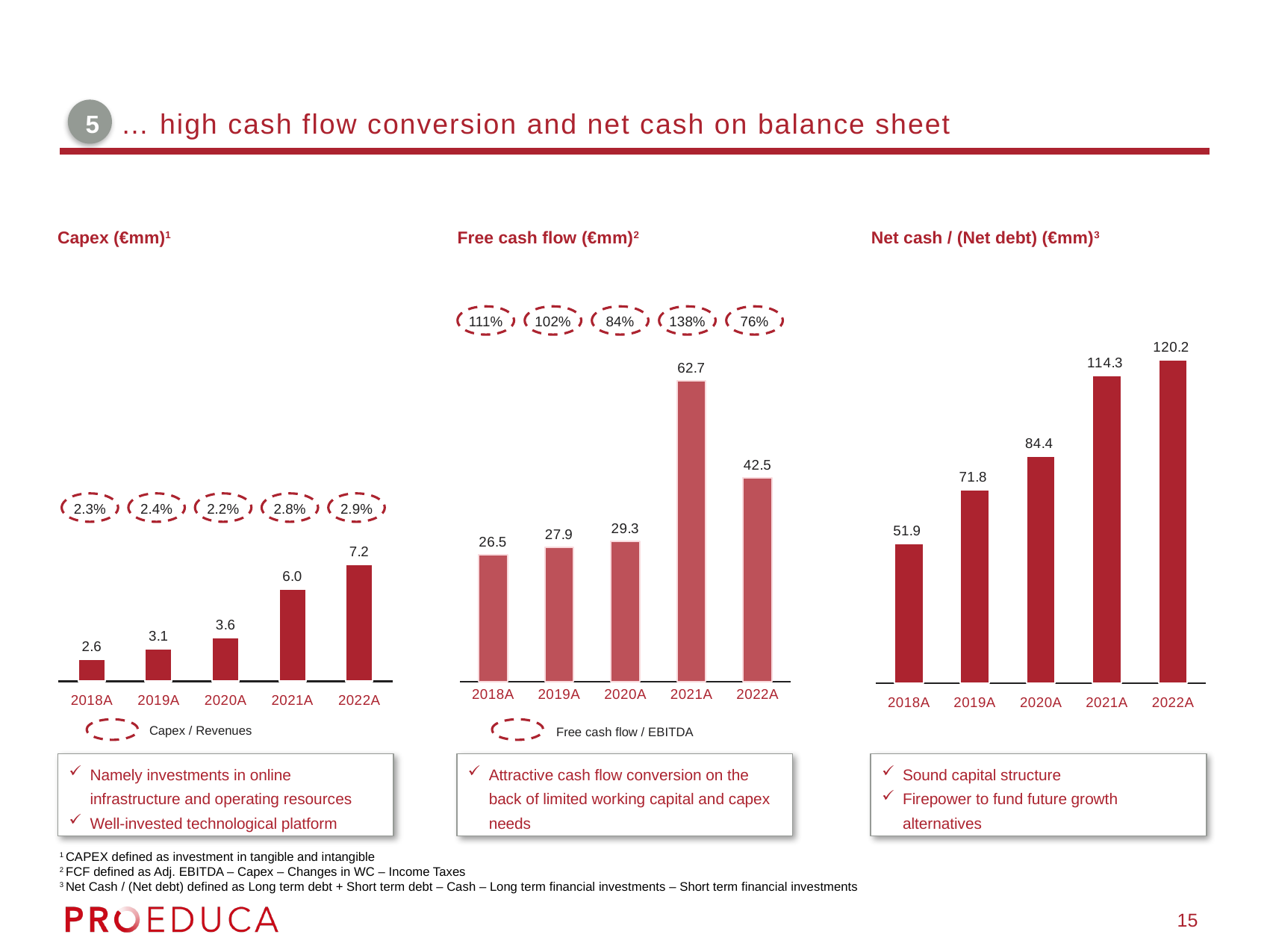
In the Free cash flow (€mm) chart, what is the difference between the 2021A and 2022A values? 20.2 In the Net cash / (Net debt) (€mm) chart, do the values rise or fall from 2018A to 2022A? rise In the Net cash / (Net debt) (€mm) chart, what is the value for 2019A? 71.8 In the Free cash flow (€mm) chart, which year has the lowest free cash flow? 2018A In the Free cash flow (€mm) chart, what Free cash flow / EBITDA percentage is shown for 2021A? 138% What kind of chart is the Net cash / (Net debt) (€mm) chart? bar chart In the Net cash / (Net debt) (€mm) chart, what is the difference between the 2022A and 2018A values? 68.3 In the Capex (€mm) chart, which year has the highest capex? 2022A How many years are shown on the x axis of the Capex (€mm) chart? 5 In the Free cash flow (€mm) chart, what is the value for 2021A? 62.7 In the Capex (€mm) chart, what is the Capex / Revenues percentage shown for 2021A? 2.8% In the Capex (€mm) chart, what is the value for 2020A? 3.6